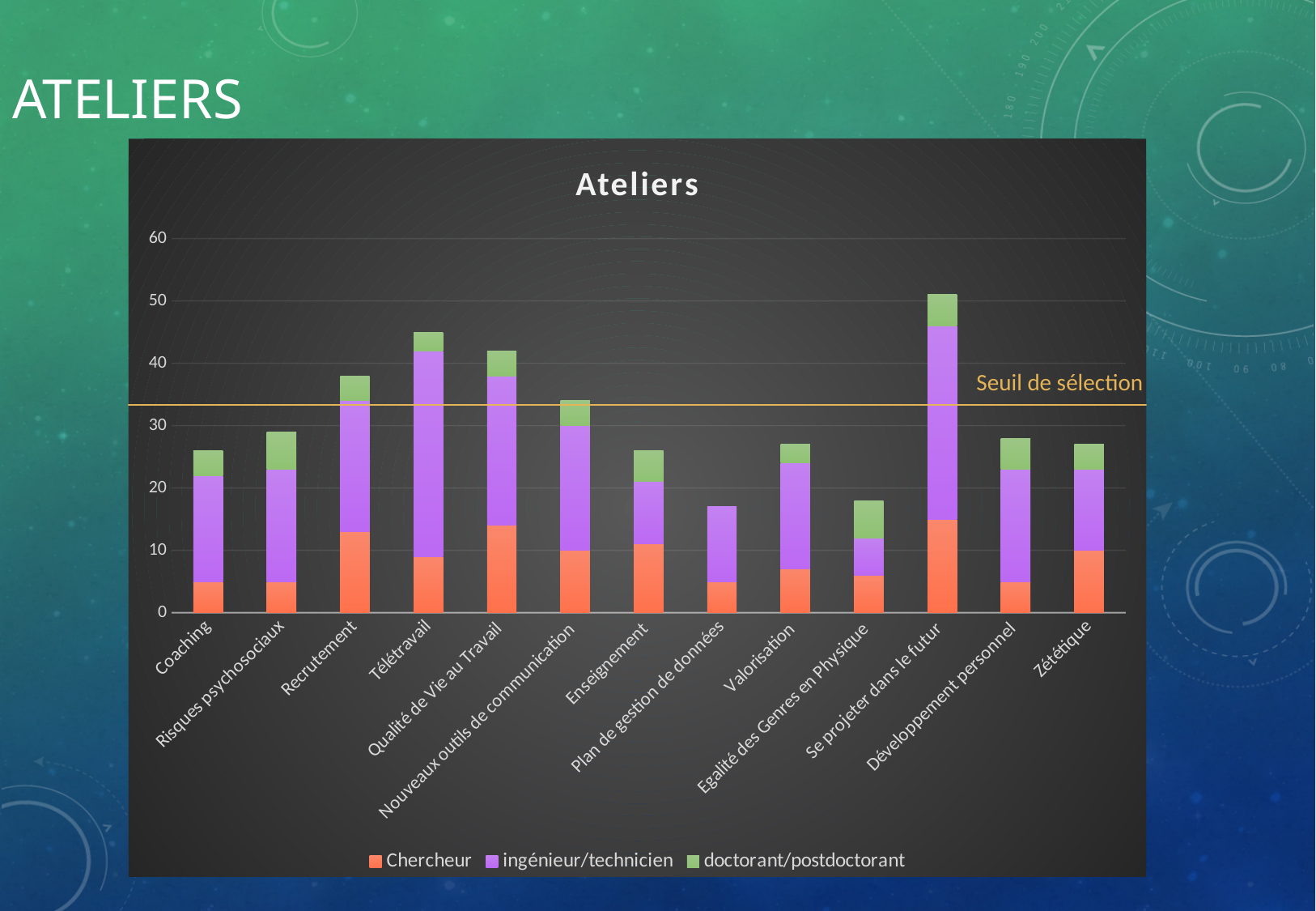
Which has the larger total bar, Se projeter dans le futur or Qualité de Vie au Travail? Se projeter dans le futur Is the total value for Télétravail greater or less than 40? greater Which has the larger total bar, Télétravail or Recrutement? Télétravail How many series does the legend list? 3 Is the total value for Plan de gestion de données greater or less than 20? less What is the title of the chart? Ateliers Is the total value for Coaching greater or less than 30? less How many categories (ateliers) are shown on the x axis? 13 Which atelier has the highest total bar? Se projeter dans le futur What label is given to the horizontal line drawn across the chart? Seuil de sélection What kind of chart is shown on the slide? bar chart